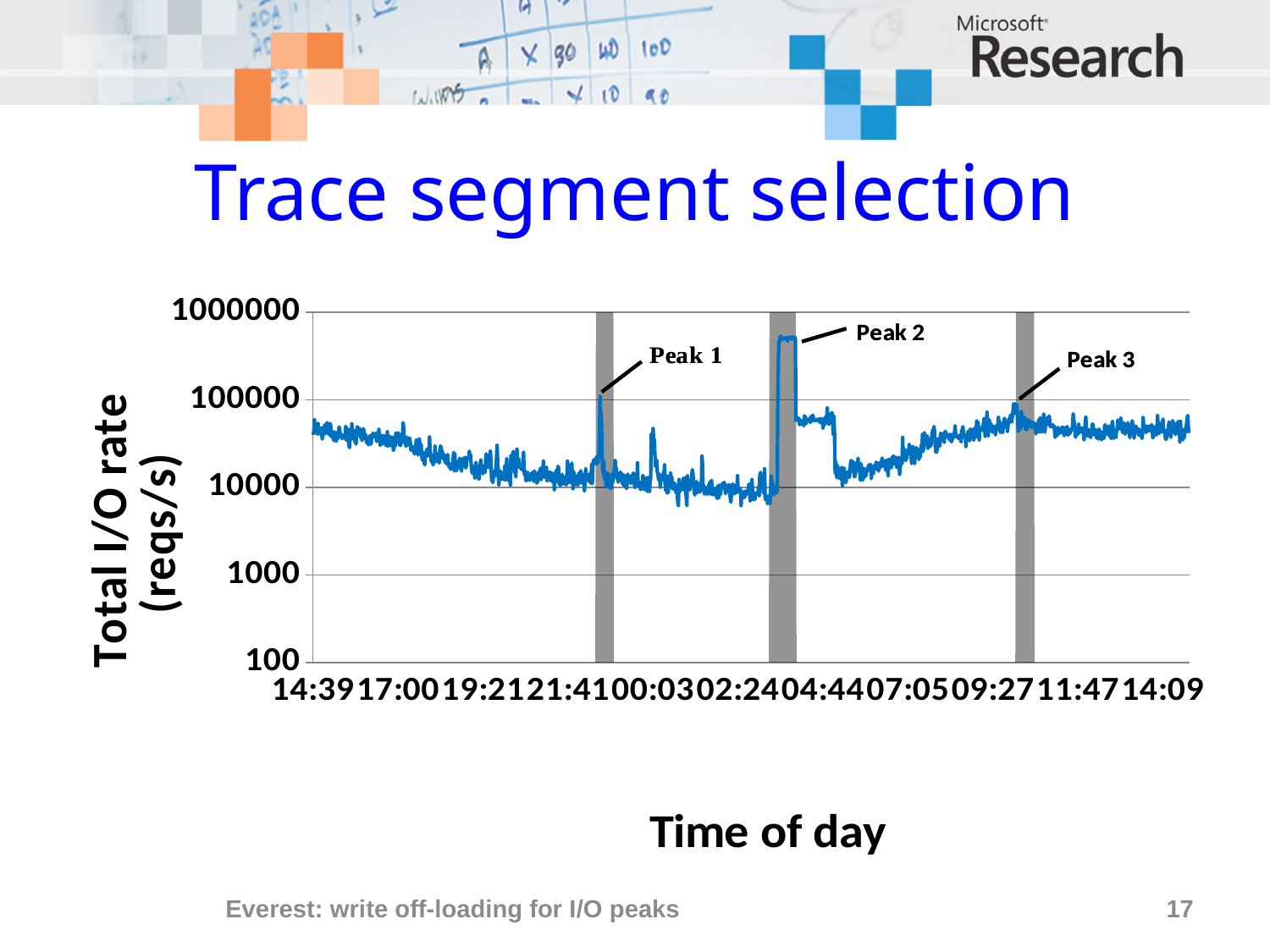
What is the label of the x axis? Time of day Which annotated peak has the lowest total I/O rate? Peak 3 Is the total I/O rate at Peak 1 greater or less than 10000 reqs/s? greater Which annotated peak has the highest total I/O rate? Peak 2 What kind of chart is shown on the slide? line chart What is the label of the y axis? Total I/O rate (reqs/s) Which is larger, the total I/O rate at Peak 1 or at Peak 2? Peak 2 How many peaks are annotated on the chart? 3 Is the total I/O rate at Peak 2 greater or less than 100000 reqs/s? greater Does the total I/O rate rise or fall between 14:39 and 21:41? fall What is the lowest value shown on the y axis? 100